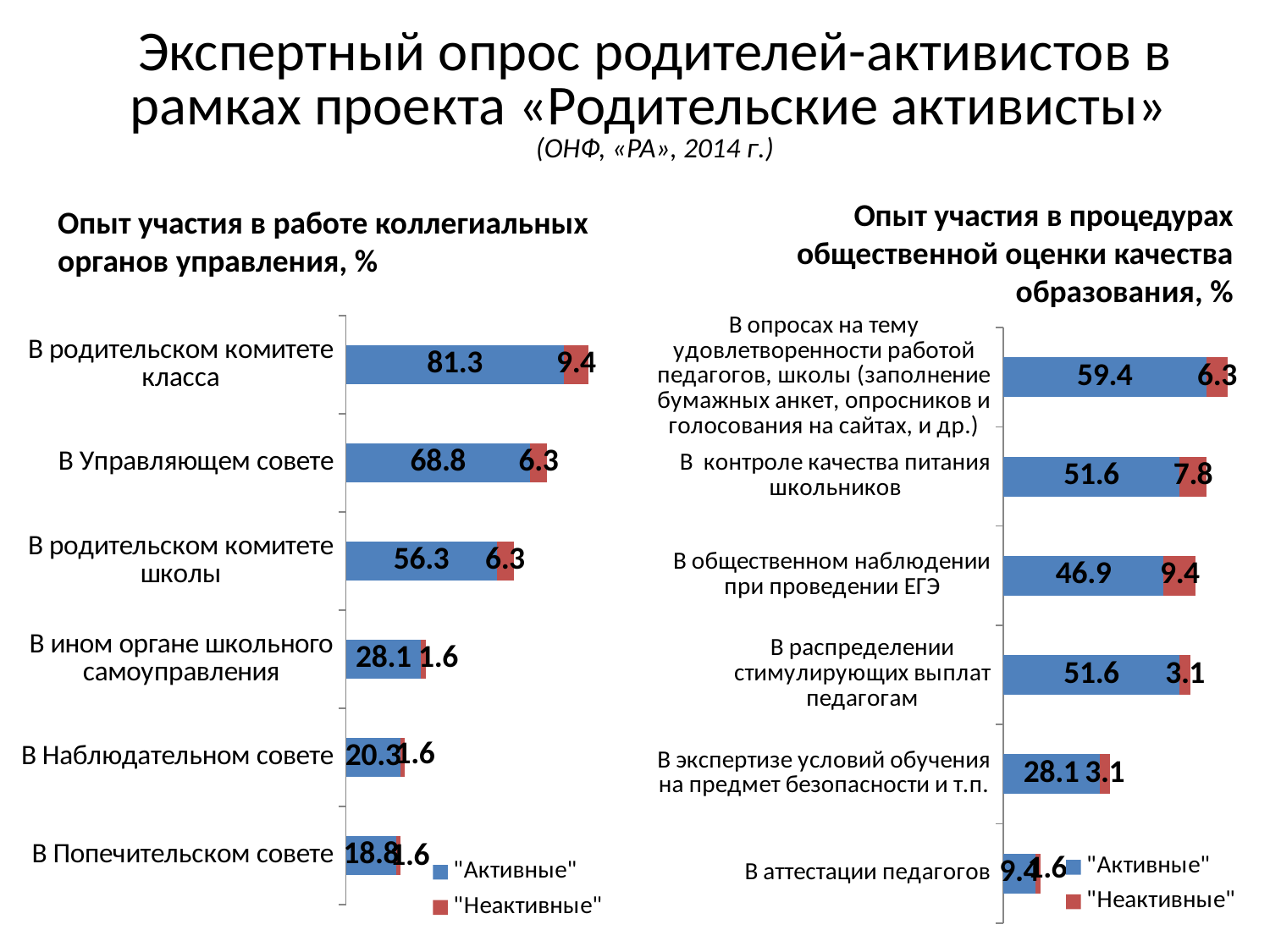
On the right chart (Опыт участия в процедурах общественной оценки качества образования), what is the total of the stacked bar for "В аттестации педагогов"? 11.0 How many categories does the left chart (Опыт участия в работе коллегиальных органов управления) show? 6 On the right chart (Опыт участия в процедурах общественной оценки качества образования), what is the value of "Неактивные" for "В общественном наблюдении при проведении ЕГЭ"? 9.4 On the right chart (Опыт участия в процедурах общественной оценки качества образования), which is larger: the "Активные" value for "В общественном наблюдении при проведении ЕГЭ" or for "В экспертизе условий обучения на предмет безопасности и т.п."? В общественном наблюдении при проведении ЕГЭ On the left chart (Опыт участия в работе коллегиальных органов управления), what is the value of "Неактивные" for "В Управляющем совете"? 6.3 On the left chart (Опыт участия в работе коллегиальных органов управления), what is the value of "Активные" for "В родительском комитете класса"? 81.3 On the left chart (Опыт участия в работе коллегиальных органов управления), which category has the lowest "Активные" value? В Попечительском совете On the right chart (Опыт участия в процедурах общественной оценки качества образования), what is the value of "Активные" for "В контроле качества питания школьников"? 51.6 How many series does the legend of the right chart (Опыт участия в процедурах общественной оценки качества образования) list? 2 What type of chart is the left chart (Опыт участия в работе коллегиальных органов управления)? Stacked bar chart On the left chart (Опыт участия в работе коллегиальных органов управления), what is the difference between the "Активные" values for "В родительском комитете класса" and "В Управляющем совете"? 12.5 On the right chart (Опыт участия в процедурах общественной оценки качества образования), which category has the highest "Активные" value? В опросах на тему удовлетворенности работой педагогов, школы (заполнение бумажных анкет, опросников и голосования на сайтах, и др.)